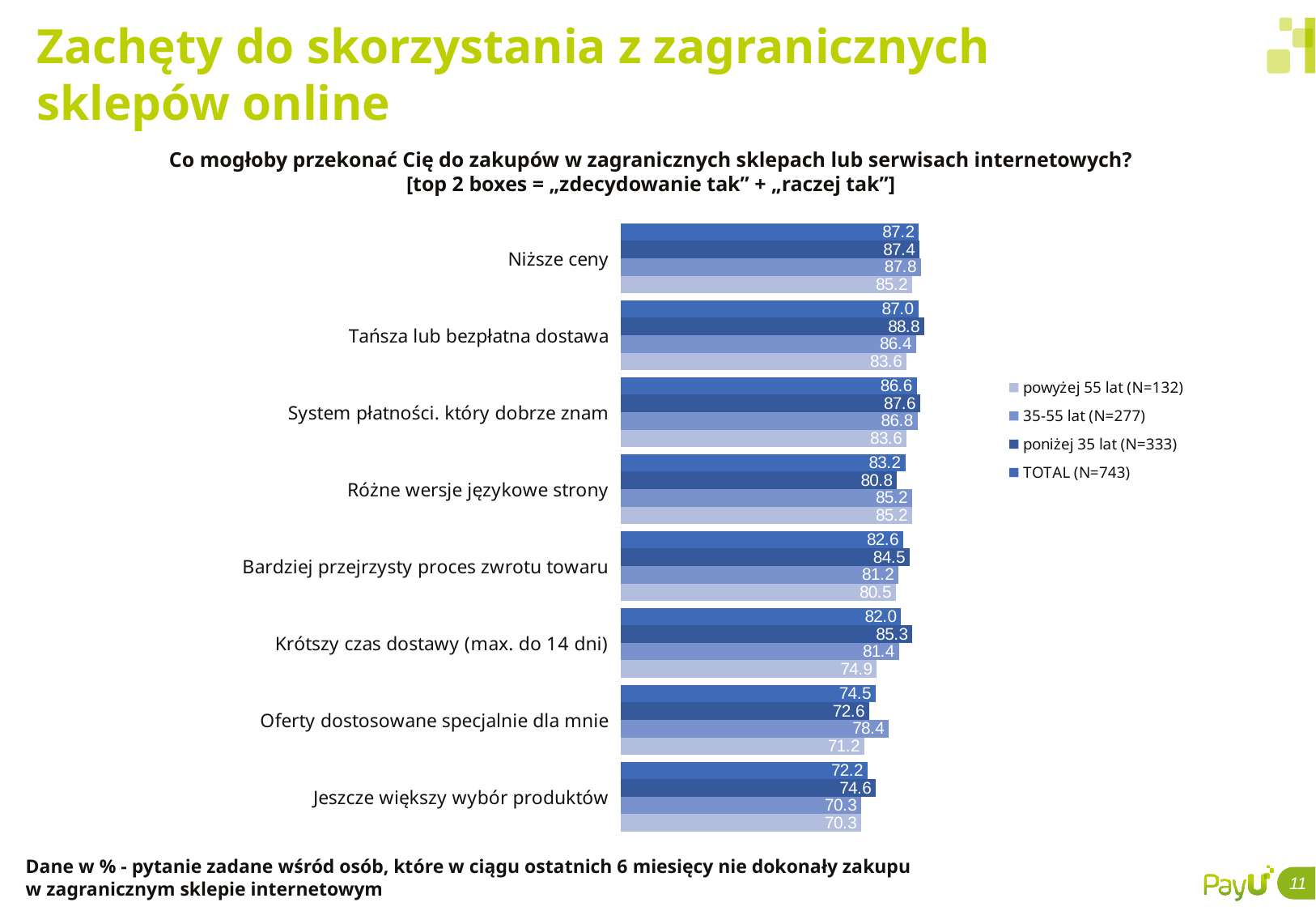
What is the value for "poniżej 35 lat (N=333)" for "Tańsza lub bezpłatna dostawa"? 88.8 For "Różne wersje językowe strony", which is larger: the value for "poniżej 35 lat (N=333)" or for "35-55 lat (N=277)"? 35-55 lat (N=277) What is the value for "35-55 lat (N=277)" for "Oferty dostosowane specjalnie dla mnie"? 78.4 What is the TOTAL (N=743) value for "Niższe ceny"? 87.2 Which category has the highest TOTAL (N=743) value? Niższe ceny What is the difference between the "poniżej 35 lat (N=333)" and "powyżej 55 lat (N=132)" values for "Krótszy czas dostawy (max. do 14 dni)"? 10.4 What kind of chart is shown on the slide? Bar chart What is the value for "powyżej 55 lat (N=132)" for "Krótszy czas dostawy (max. do 14 dni)"? 74.9 How many series does the legend list? 4 What is the difference between the TOTAL (N=743) values for "Niższe ceny" and "Jeszcze większy wybór produktów"? 15.0 How many categories are shown on the chart? 8 Which category has the lowest TOTAL (N=743) value? Jeszcze większy wybór produktów